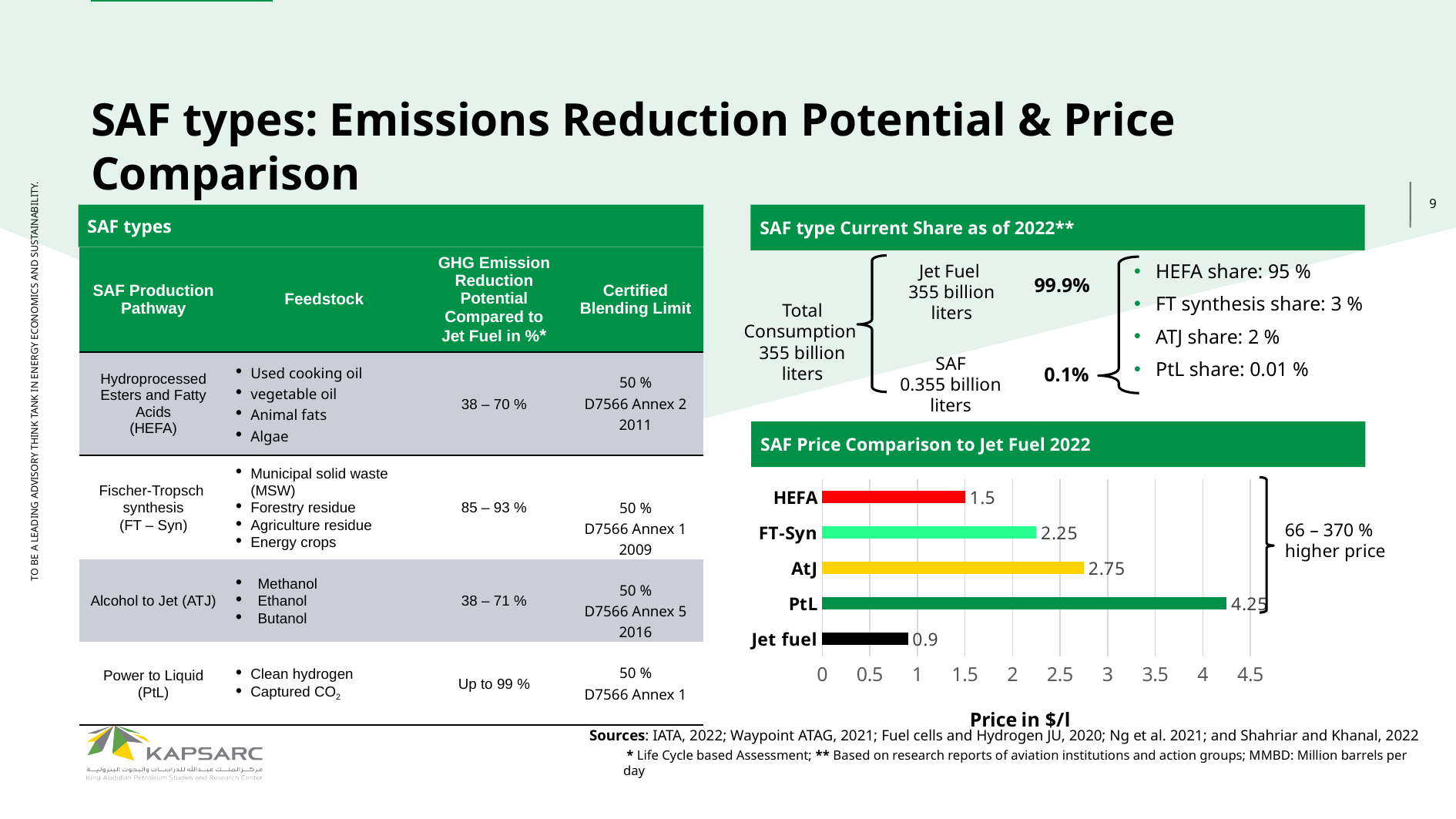
In the SAF Price Comparison to Jet Fuel 2022 chart, which fuel has the lowest price? Jet fuel In the SAF Price Comparison to Jet Fuel 2022 chart, what is the difference in price between FT-Syn and HEFA? 0.75 In the SAF Price Comparison to Jet Fuel 2022 chart, what is the price for AtJ? 2.75 In the SAF Price Comparison to Jet Fuel 2022 chart, which fuel has the highest price? PtL In the SAF Price Comparison to Jet Fuel 2022 chart, which has a higher price, AtJ or FT-Syn? AtJ What is the x-axis label of the SAF Price Comparison to Jet Fuel 2022 chart? Price in $/l What type of chart is the SAF Price Comparison to Jet Fuel 2022 chart? Bar chart In the SAF Price Comparison to Jet Fuel 2022 chart, what is the price for Jet fuel? 0.9 In the SAF Price Comparison to Jet Fuel 2022 chart, what is the price for HEFA? 1.5 In the SAF Price Comparison to Jet Fuel 2022 chart, what is the price for PtL? 4.25 In the SAF Price Comparison to Jet Fuel 2022 chart, what is the difference in price between PtL and Jet fuel? 3.35 How many fuel categories are shown in the SAF Price Comparison to Jet Fuel 2022 chart? 5